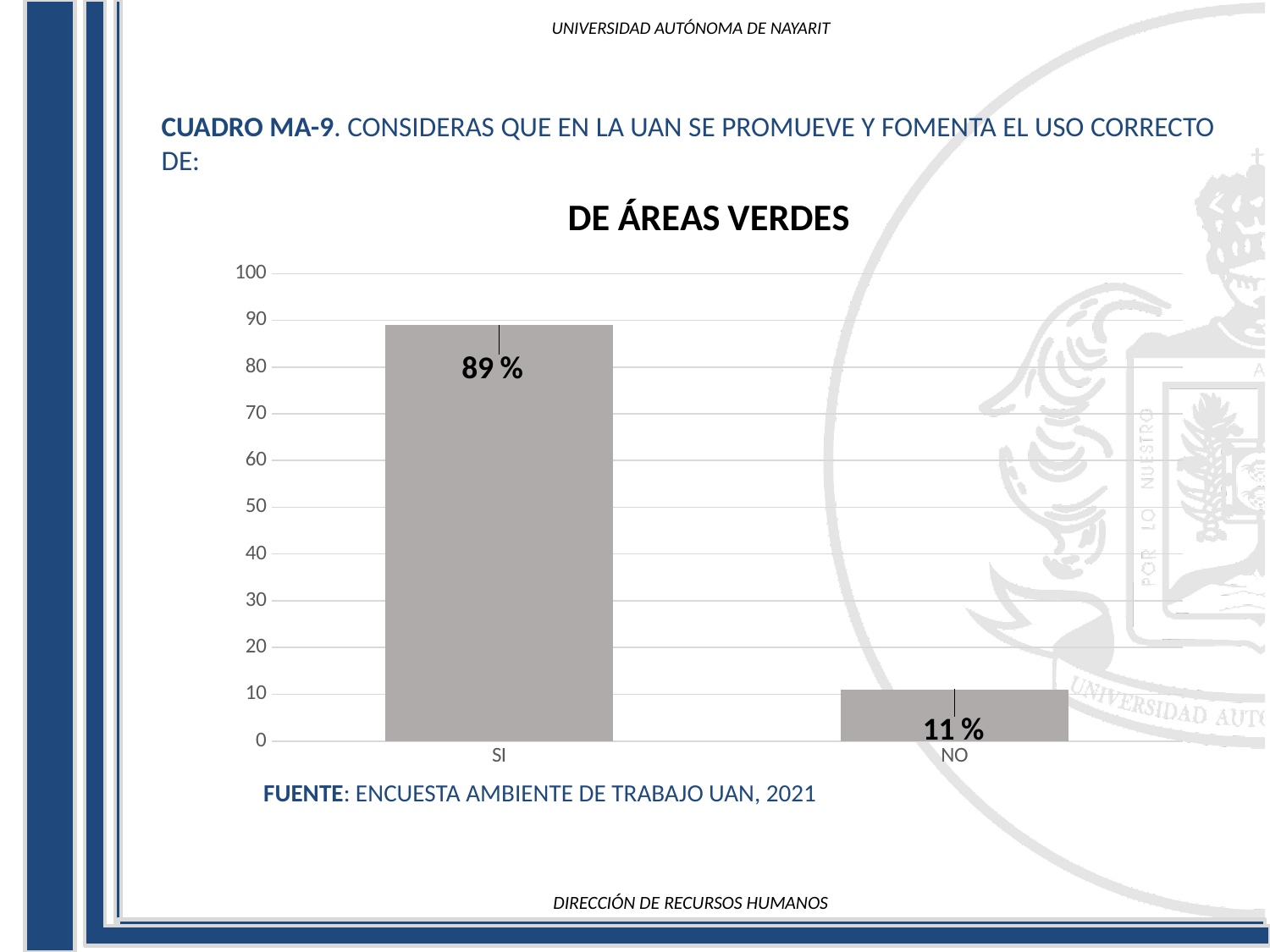
Which is larger, the value for SI or the value for NO? SI What is the value for SI in the chart? 89 % Which category has the highest value? SI Which category has the lowest value? NO What is the maximum value shown on the vertical axis? 100 What is the title of the chart? DE ÁREAS VERDES Is the value for NO greater or less than 20? less How many categories are shown in the chart? 2 What is the value for NO in the chart? 11 % Is the value for SI greater or less than 80? greater What kind of chart is shown on the slide? bar chart What is the difference between the values for SI and NO? 78 %